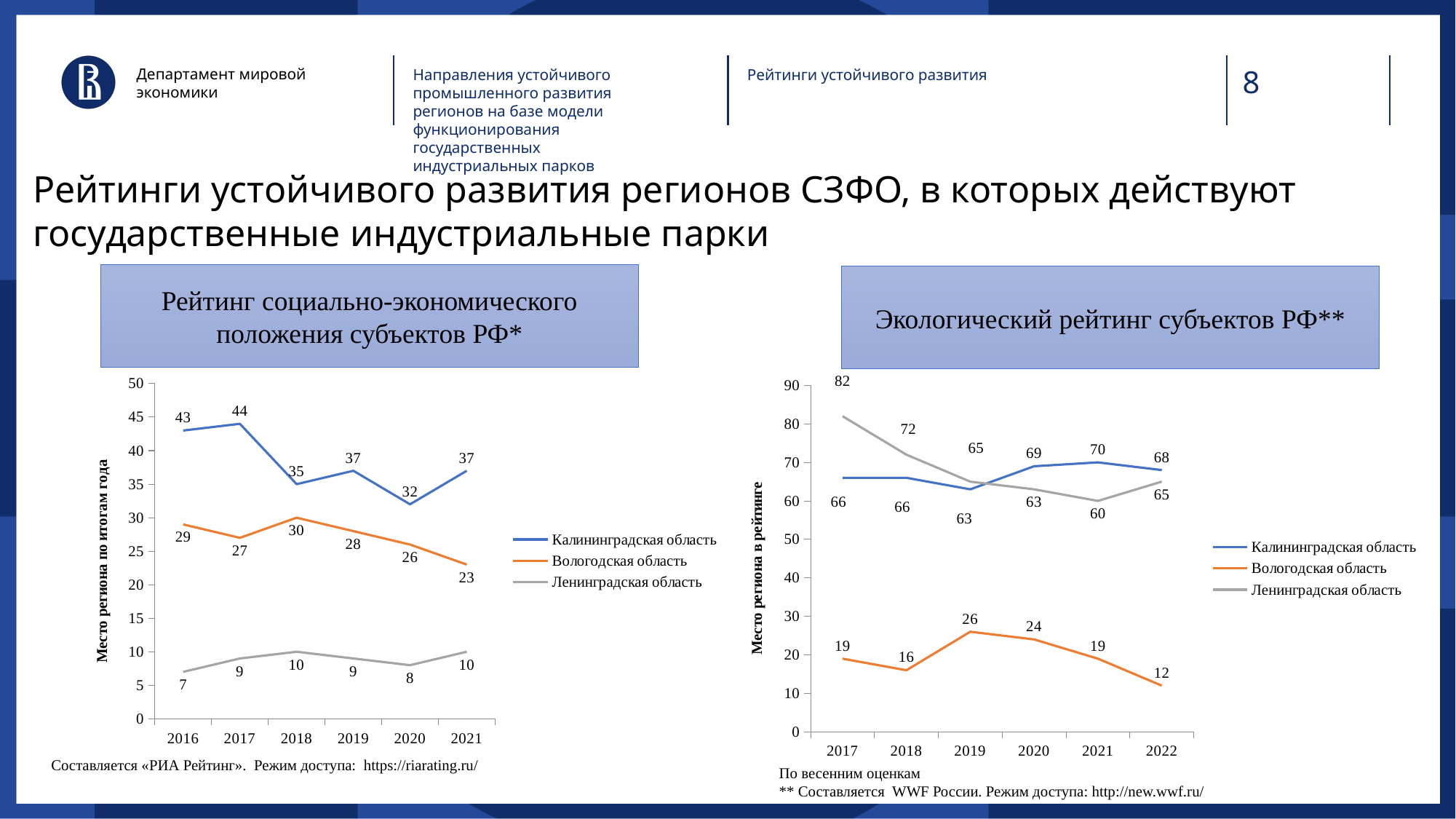
In the left chart (Рейтинг социально-экономического положения субъектов РФ*), what is the value for Калининградская область in 2017? 44 How many series does the legend of the right chart (Экологический рейтинг субъектов РФ**) list? 3 In the left chart (Рейтинг социально-экономического положения субъектов РФ*), in which year is the value for Ленинградская область lowest? 2016 In the left chart (Рейтинг социально-экономического положения субъектов РФ*), what is the value for Вологодская область in 2021? 23 In the right chart (Экологический рейтинг субъектов РФ**), which is larger in 2019: the value for Калининградская область or Ленинградская область? Ленинградская область In the right chart (Экологический рейтинг субъектов РФ**), in which year is the value for Калининградская область highest? 2021 In the right chart (Экологический рейтинг субъектов РФ**), what is the value for Ленинградская область in 2017? 82 In the left chart (Рейтинг социально-экономического положения субъектов РФ*), what is the difference between the values for Калининградская область and Вологодская область in 2020? 6 In the right chart (Экологический рейтинг субъектов РФ**), does the value for Ленинградская область rise or fall from 2017 to 2021? Fall What type of chart is the left chart (Рейтинг социально-экономического положения субъектов РФ*)? Line chart In the right chart (Экологический рейтинг субъектов РФ**), what is the value for Вологодская область in 2022? 12 In the left chart (Рейтинг социально-экономического положения субъектов РФ*), how many years are shown on the x axis? 6